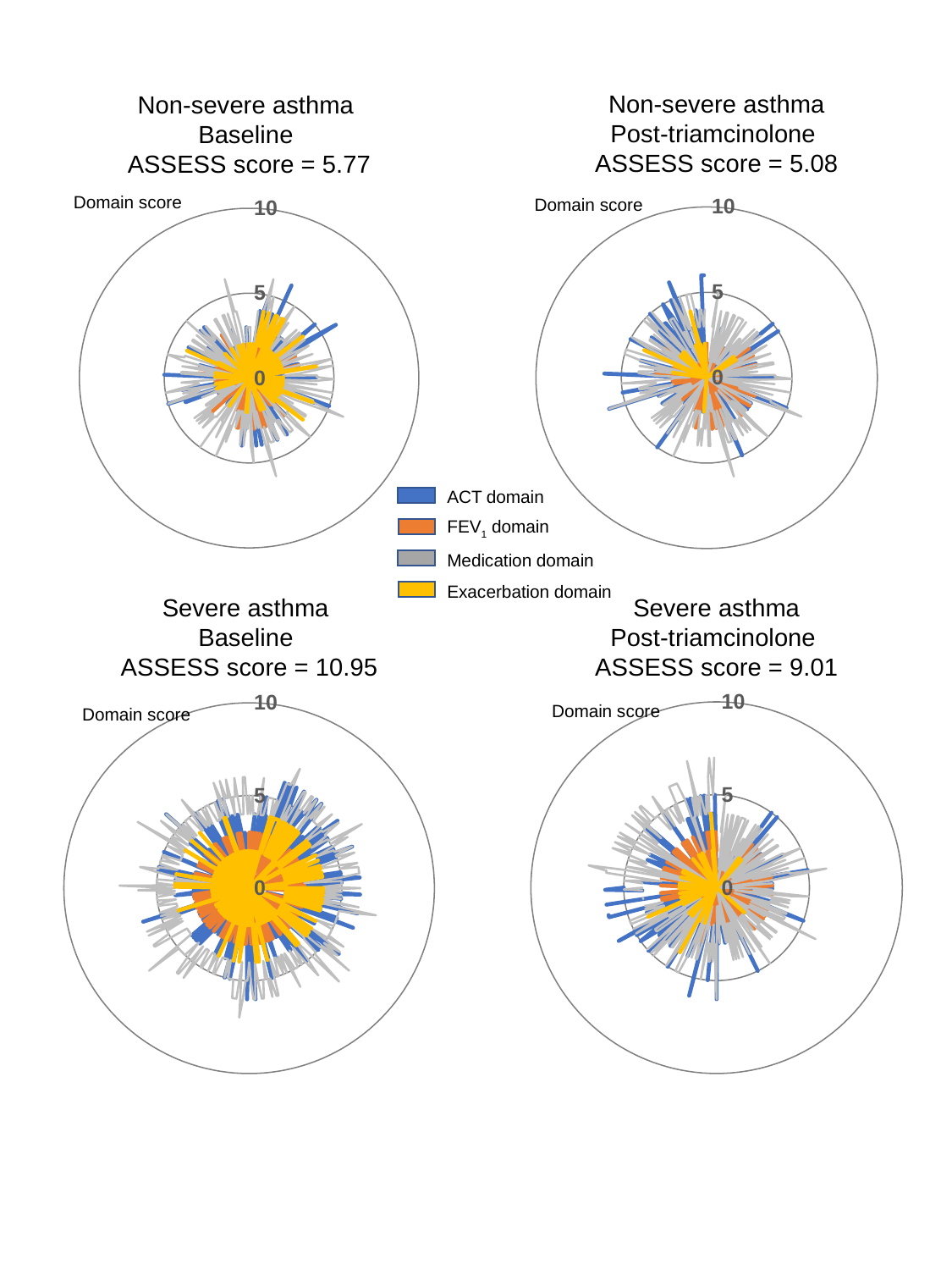
What is the ASSESS score shown for the Severe asthma Post-triamcinolone chart? 9.01 Which of the four charts has the lowest ASSESS score? Non-severe asthma Post-triamcinolone What colour represents the Exacerbation domain in the legend? Yellow What kind of chart is used in each of the four panels? Radial (polar) bar chart What is the ASSESS score shown for the Severe asthma Baseline chart? 10.95 What is the ASSESS score shown for the Non-severe asthma Post-triamcinolone chart? 5.08 What is the difference between the ASSESS scores of the Severe asthma Baseline chart and the Severe asthma Post-triamcinolone chart? 1.94 What is the ASSESS score shown for the Non-severe asthma Baseline chart? 5.77 How many domains does the legend list? 4 What is the difference between the ASSESS scores of the Non-severe asthma Baseline chart and the Non-severe asthma Post-triamcinolone chart? 0.69 Which of the four charts has the highest ASSESS score? Severe asthma Baseline Which has the larger ASSESS score: the Severe asthma Baseline chart or the Non-severe asthma Baseline chart? Severe asthma Baseline